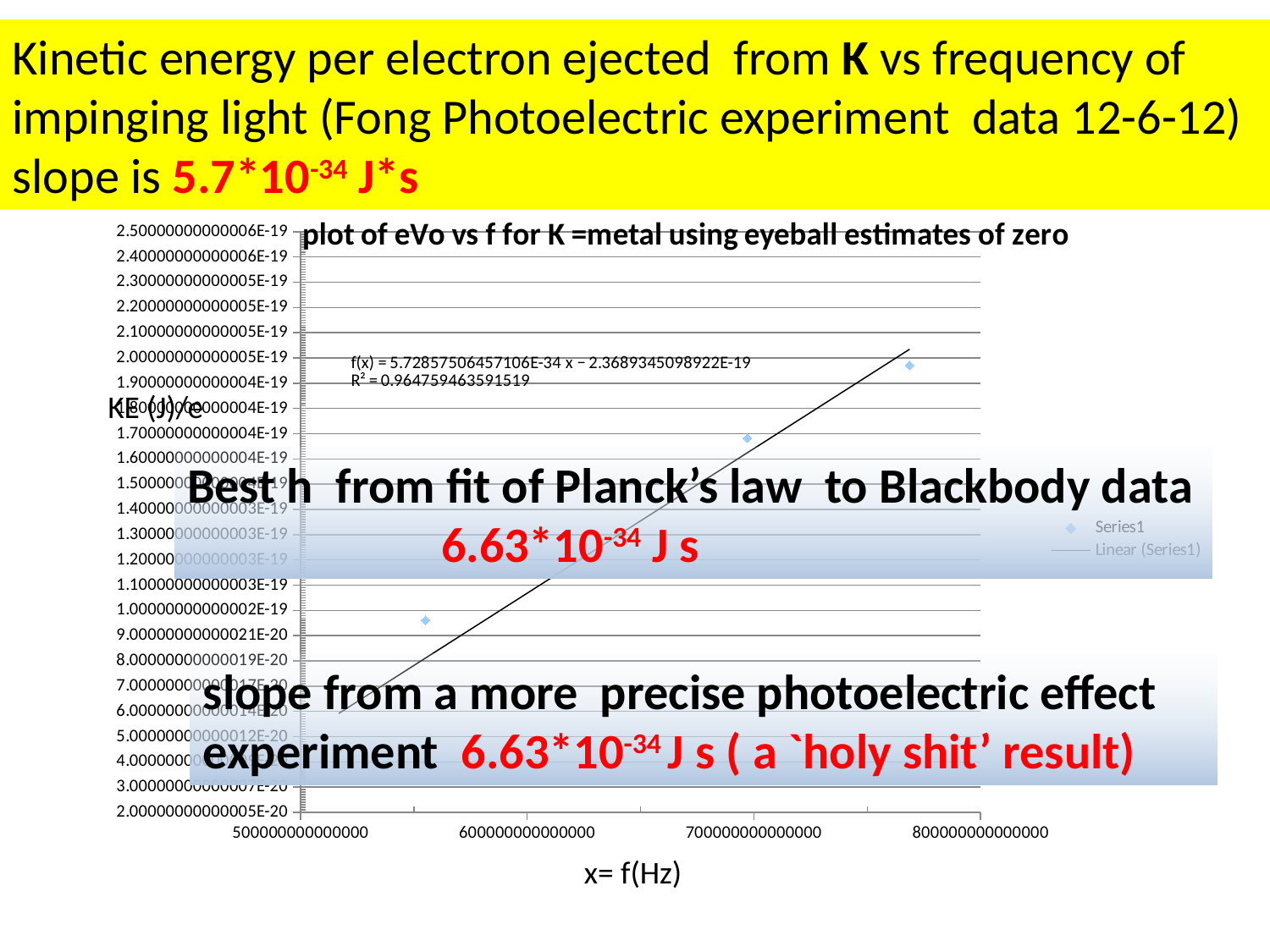
Is the value of the leftmost data point (near 550000000000000 Hz) greater or less than 1.00000000000002E-19? less Is the value of the middle data point (near 690000000000000 Hz) greater or less than 1.60000000000004E-19? greater What is the title of the chart? plot of eVo vs f for K =metal using eyeball estimates of zero What is the R² value shown for the linear fit on the chart? 0.964759463591519 What kind of chart is shown on the slide? scatter chart with a linear trendline What is the label of the x axis of the chart? x= f(Hz) How many entries does the chart legend list? 2 Which data point has the highest kinetic energy value, the leftmost or the rightmost? the rightmost Do the plotted values rise or fall as frequency increases along the x axis? rise Is the value of the rightmost data point (near 780000000000000 Hz) greater or less than 1.80000000000004E-19? greater